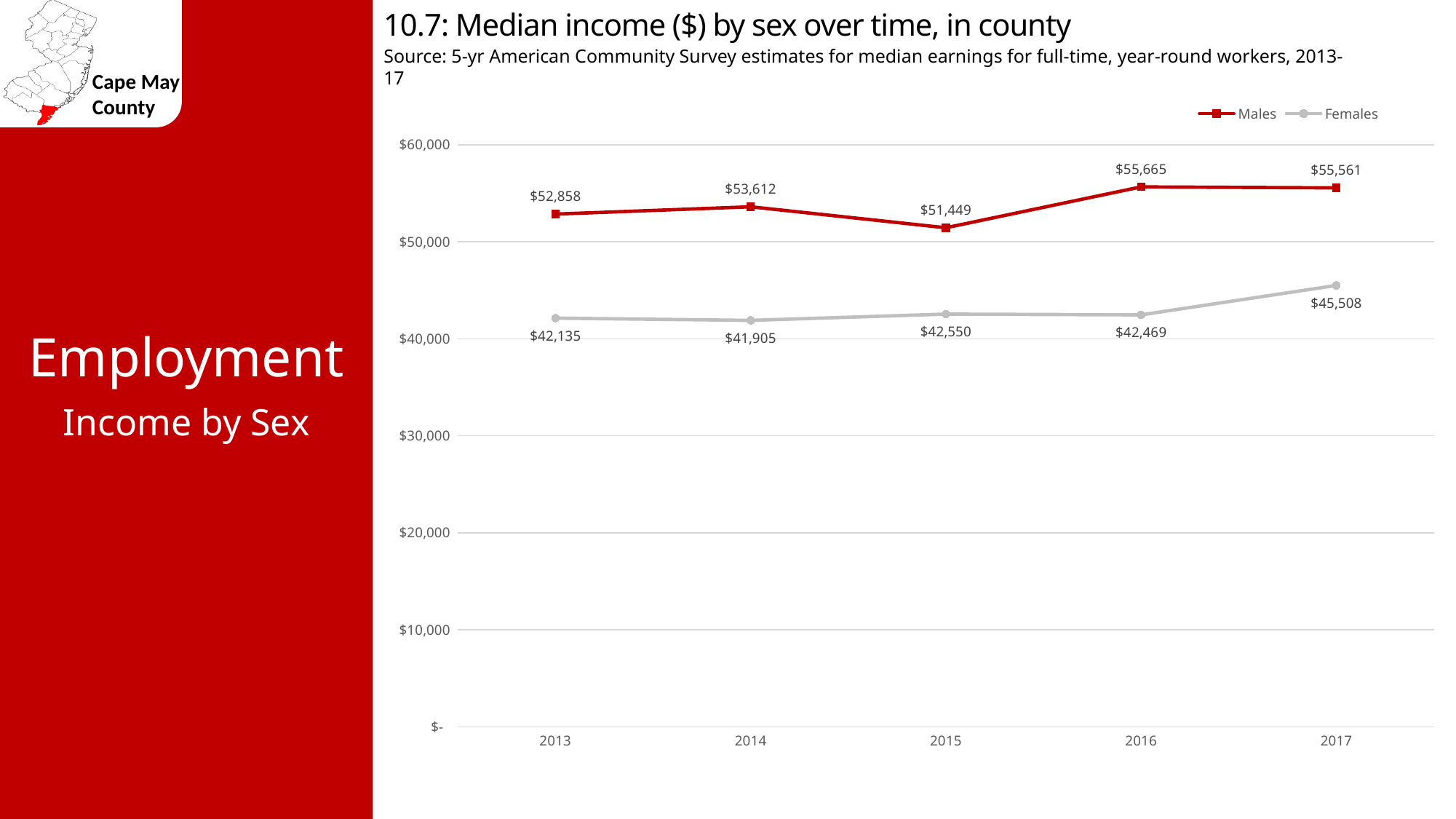
What was the median income for Females in 2014? $41,905 In which year was the median income for Females lowest? 2014 Did the median income for Females rise or fall from 2016 to 2017? Rise Is the median income for Females in 2017 greater or less than $40,000? greater What kind of chart is shown on the slide? Line chart Which was larger in 2013: the median income for Males or for Females? Males How many series does the legend list? 2 What was the median income for Males in 2015? $51,449 In which year was the median income for Males highest? 2016 How many years are shown on the x axis? 5 What is the difference between the Males and Females median income in 2017? $10,053 What was the median income for Females in 2017? $45,508